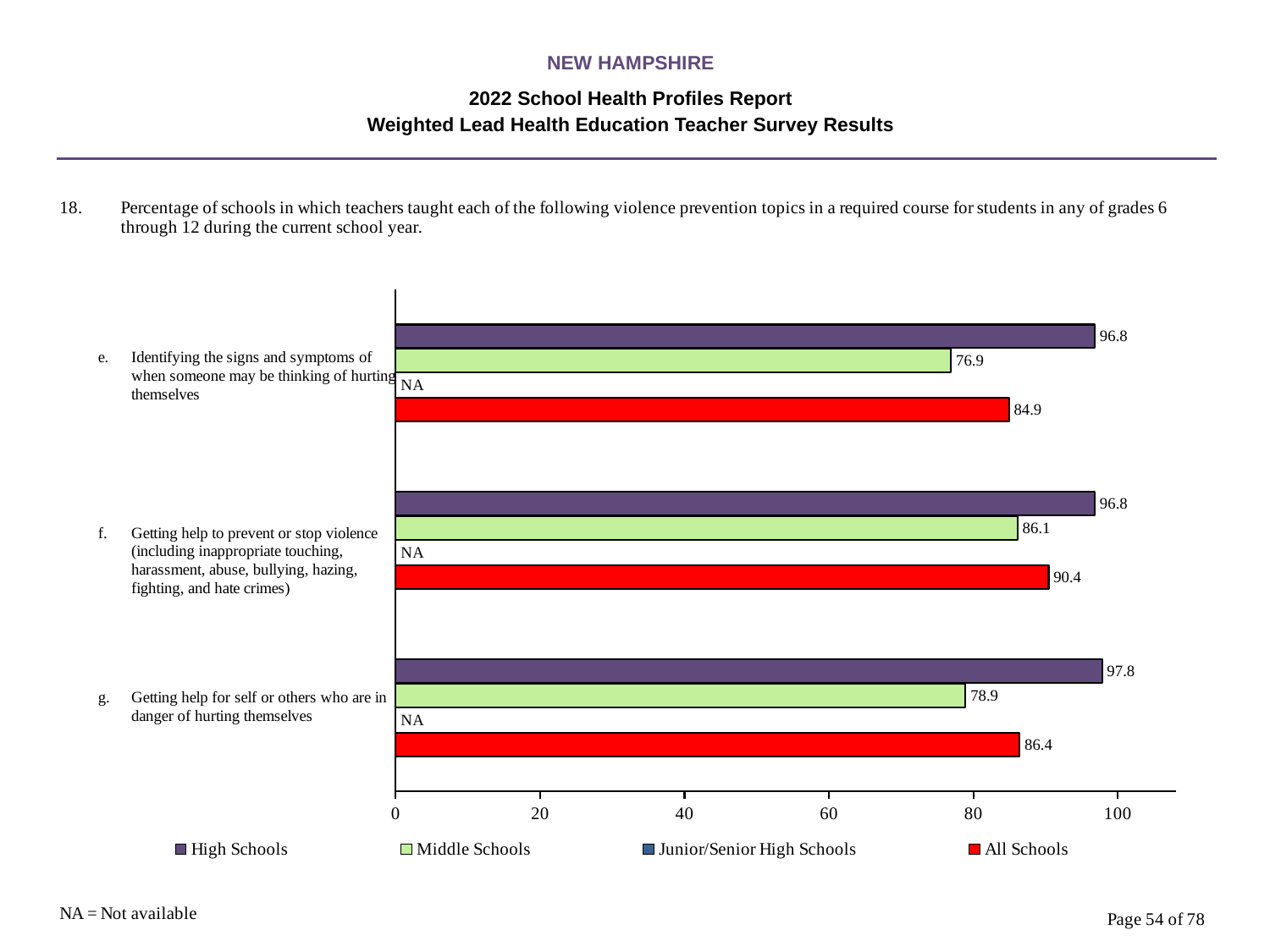
What kind of chart is shown on the slide? bar chart What is the value for All Schools for topic e, identifying the signs and symptoms of when someone may be thinking of hurting themselves? 84.9 What is the difference between the High Schools and Middle Schools values for topic e? 19.9 What is the value for High Schools for topic g, getting help for self or others who are in danger of hurting themselves? 97.8 How many series does the legend list? 4 Is the Middle Schools value for topic e greater or less than 80? less What is the value for Middle Schools for topic f, getting help to prevent or stop violence? 86.1 How many topics are shown on the chart? 3 What value is shown for Junior/Senior High Schools for topic f? NA Which is larger for topic g: the Middle Schools value or the All Schools value? All Schools Which topic has the lowest value for All Schools? e. Identifying the signs and symptoms of when someone may be thinking of hurting themselves Which topic has the highest value for Middle Schools? f. Getting help to prevent or stop violence